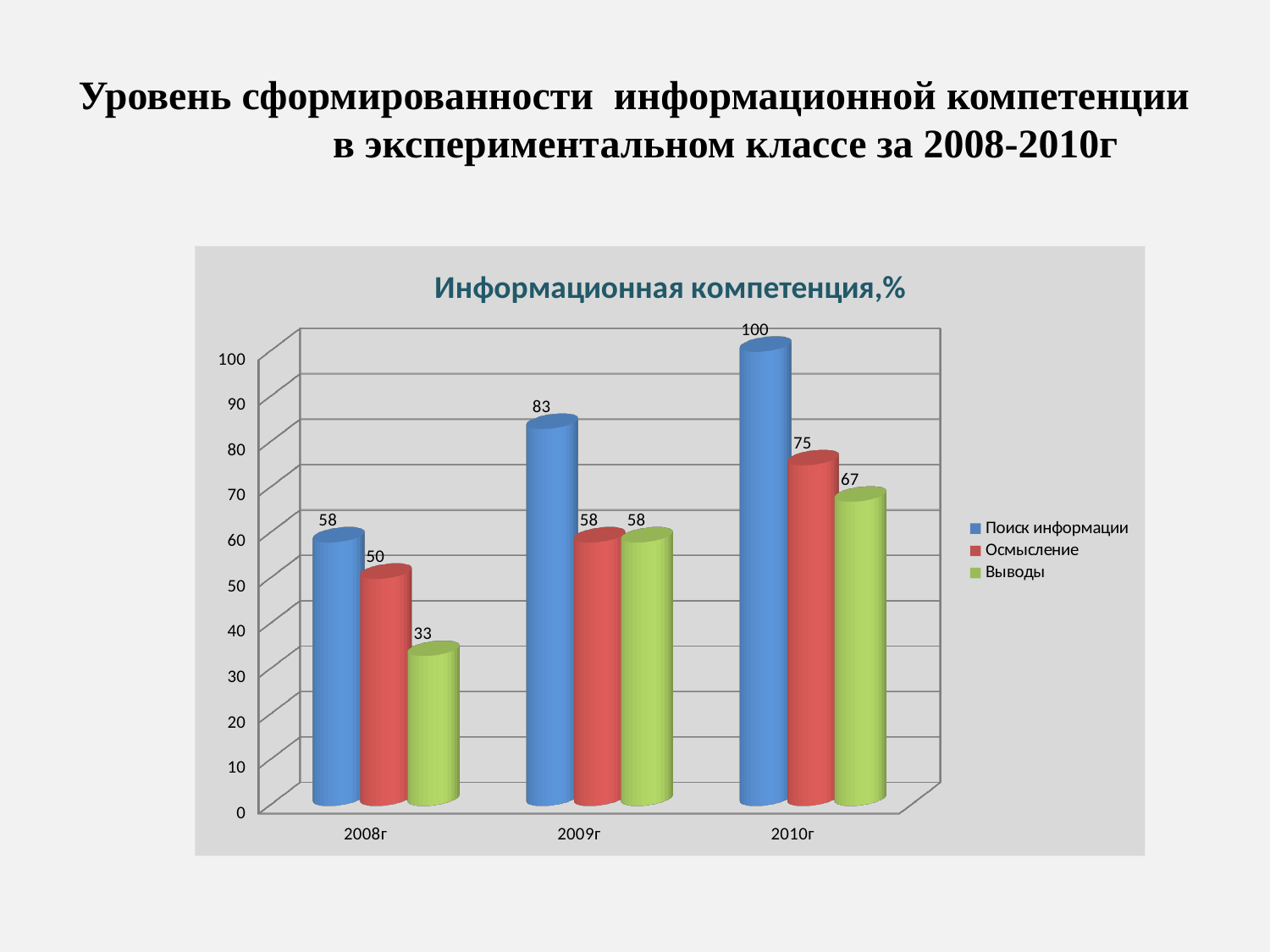
What is the value for Осмысление in 2009г? 58 Which year has the highest value for Выводы? 2010г Which series has the lowest value in 2008г? Выводы What is the value for Выводы in 2008г? 33 Does the value for Осмысление rise or fall from 2008г to 2010г? rise How many years are shown on the x axis? 3 What is the title of the chart? Информационная компетенция,% What kind of chart is shown? bar chart What is the value for Поиск информации in 2010г? 100 What is the difference between Поиск информации and Осмысление in 2010г? 25 Which is larger in 2009г: Поиск информации or Выводы? Поиск информации How many series does the legend list? 3